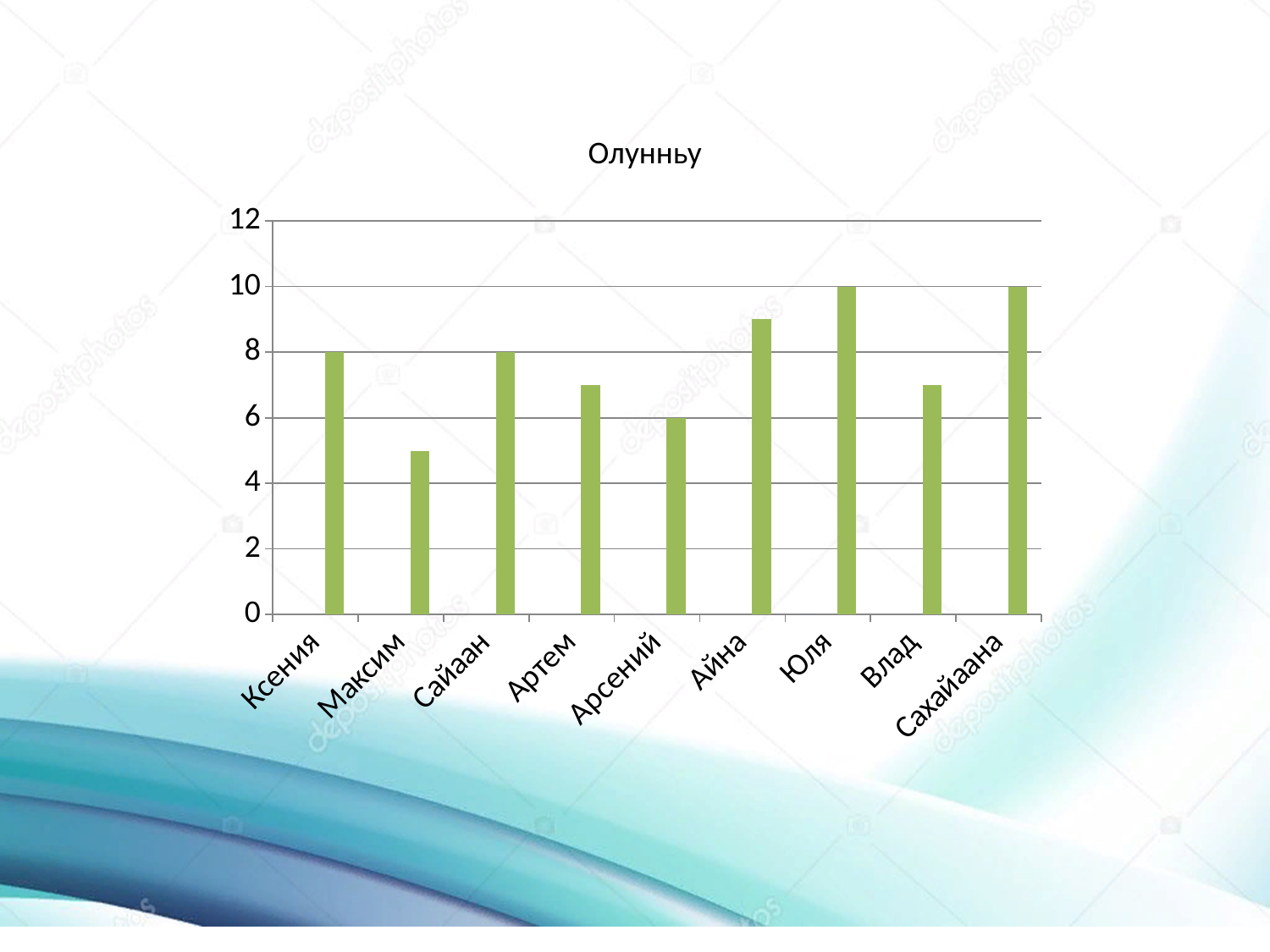
Is the value for Максим greater or less than 6? less What is the difference between the values for Сахайаана and Арсений? 4 What is the value for Юля? 10 What is the value for Арсений? 6 What is the title of the chart? Олунньу What is the value for Ксения? 8 Is the value for Айна greater or less than 8? greater Which is larger, the value for Айна or the value for Влад? Айна What is the value for Сахайаана? 10 What kind of chart is shown on the slide? bar chart Which category has the lowest value? Максим How many categories are shown on the x axis of the chart? 9